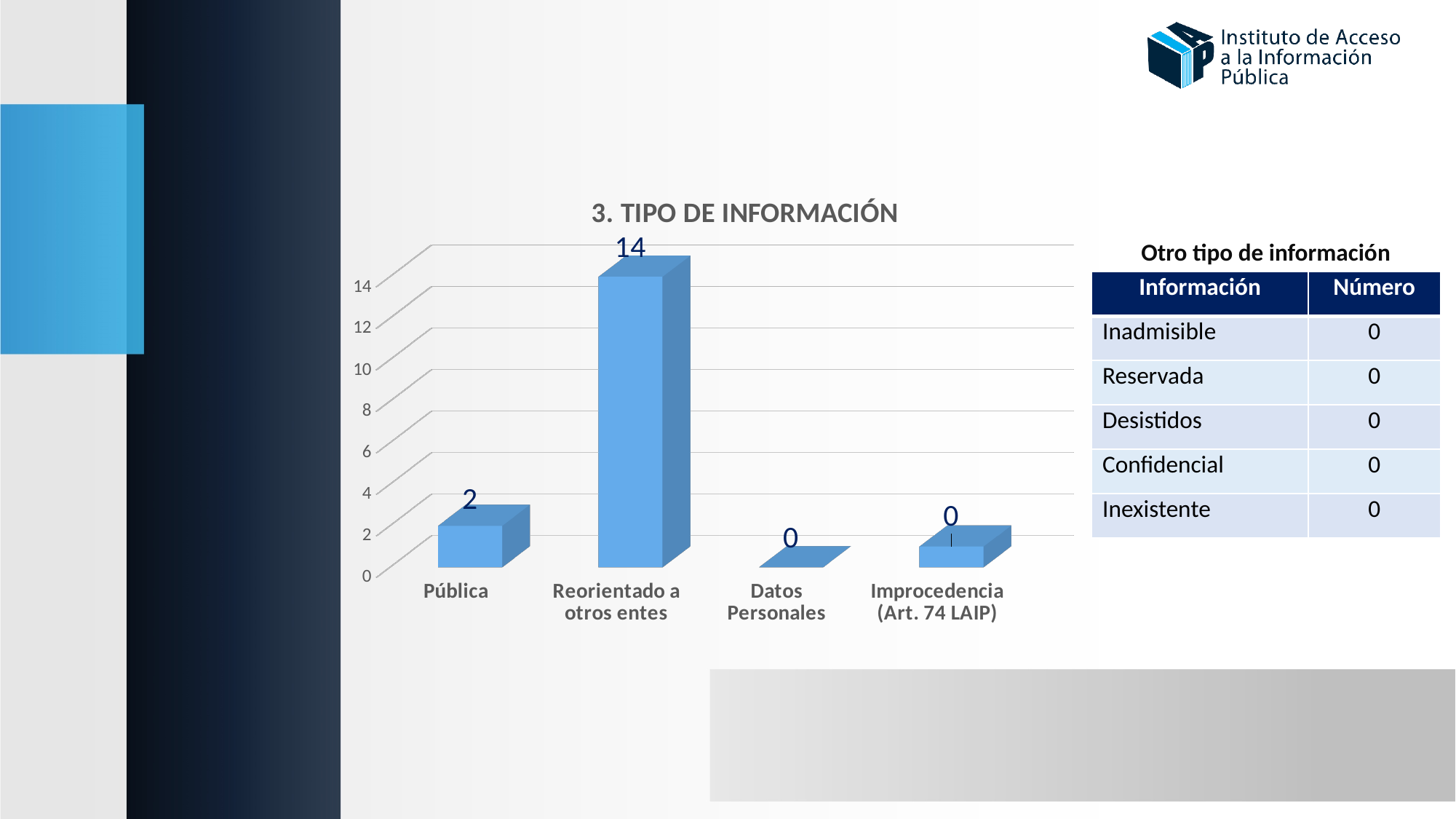
What is the value for Datos Personales? 0 What is the value for Reorientado a otros entes? 14 What is the difference between the values for Reorientado a otros entes and Pública? 12 What kind of chart is shown on the slide? Bar chart What is the value for Pública in the chart? 2 Is the value for Pública greater or less than 4? less Which category has the highest value in the chart? Reorientado a otros entes How many categories are shown on the x axis of the chart? 4 Is the value for Reorientado a otros entes greater or less than 10? greater Which is larger, the value for Pública or the value for Reorientado a otros entes? Reorientado a otros entes What is the title of the chart? 3. TIPO DE INFORMACIÓN